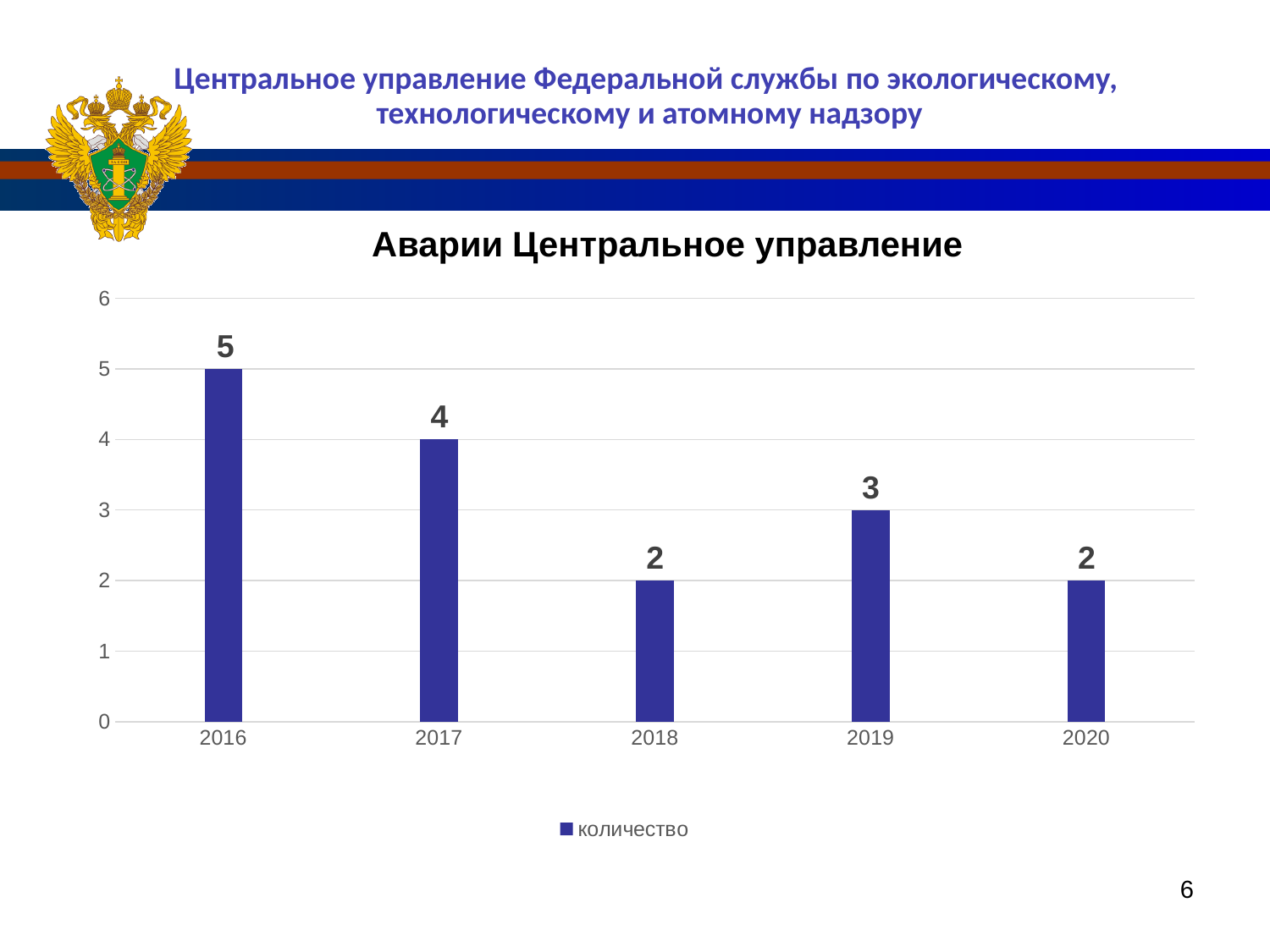
What kind of chart is shown? bar chart What is the value for 2020? 2 What is the difference between the values for 2016 and 2017? 1 Which is larger, the value for 2019 or the value for 2020? 2019 Which year has the highest value? 2016 What is the title of the chart? Аварии Центральное управление How many years are shown on the x axis? 5 What is the name of the series in the legend? количество What is the difference between the values for 2017 and 2018? 2 What is the value for 2016? 5 How many series does the legend list? 1 What is the value for 2019? 3